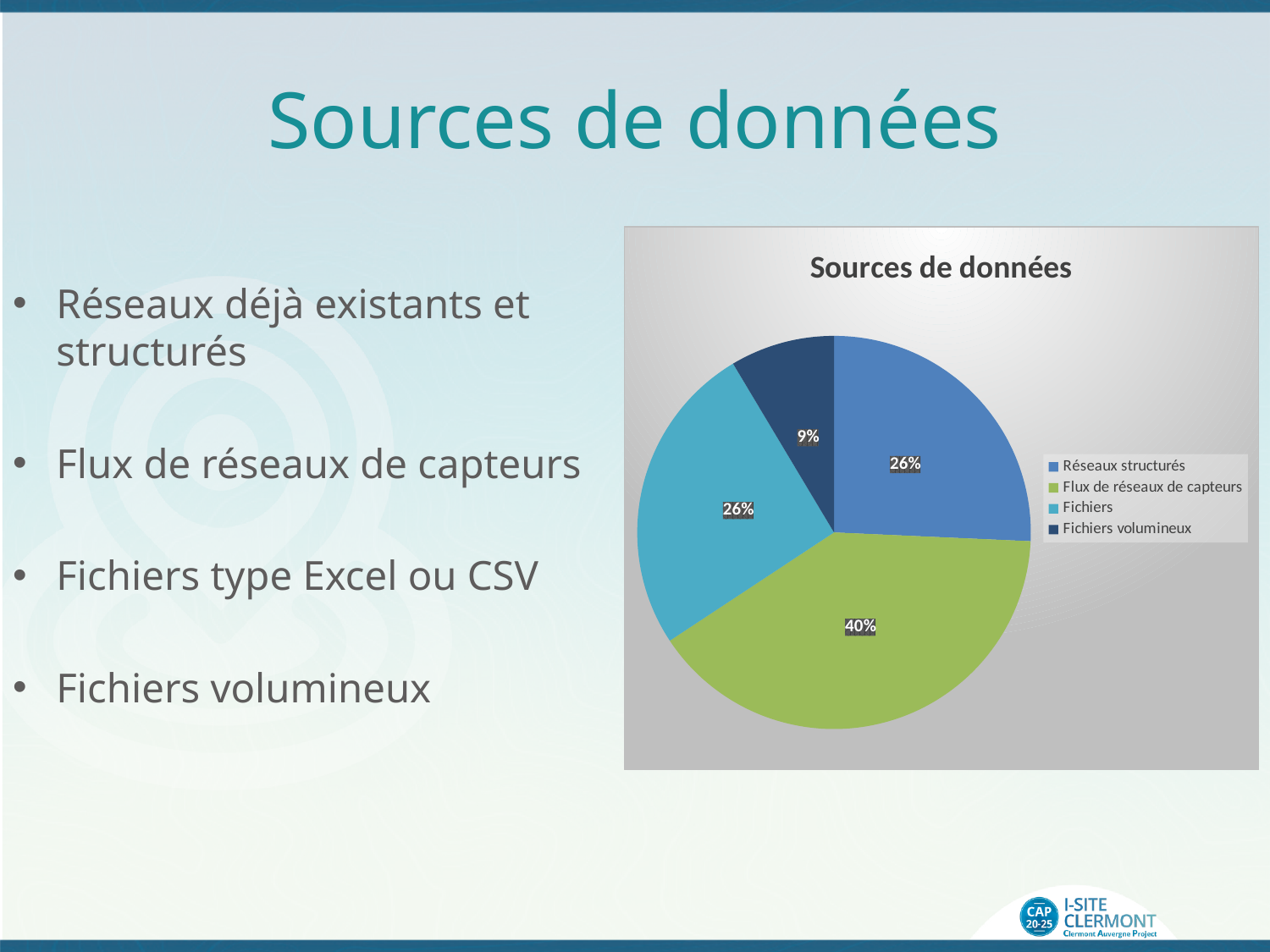
What is the difference in percentage points between Flux de réseaux de capteurs and Fichiers volumineux? 31 What is the title of the chart? Sources de données Which category has the largest slice of the pie? Flux de réseaux de capteurs What percentage does the Fichiers volumineux slice show? 9% Which is larger, the Flux de réseaux de capteurs slice or the Fichiers slice? Flux de réseaux de capteurs How many entries does the legend list? 4 What percentage does the Fichiers slice show? 26% What percentage does the Flux de réseaux de capteurs slice show? 40% How many categories does the pie chart have? 4 What kind of chart is shown on the slide? pie chart Which category has the smallest slice of the pie? Fichiers volumineux What percentage does the Réseaux structurés slice show? 26%